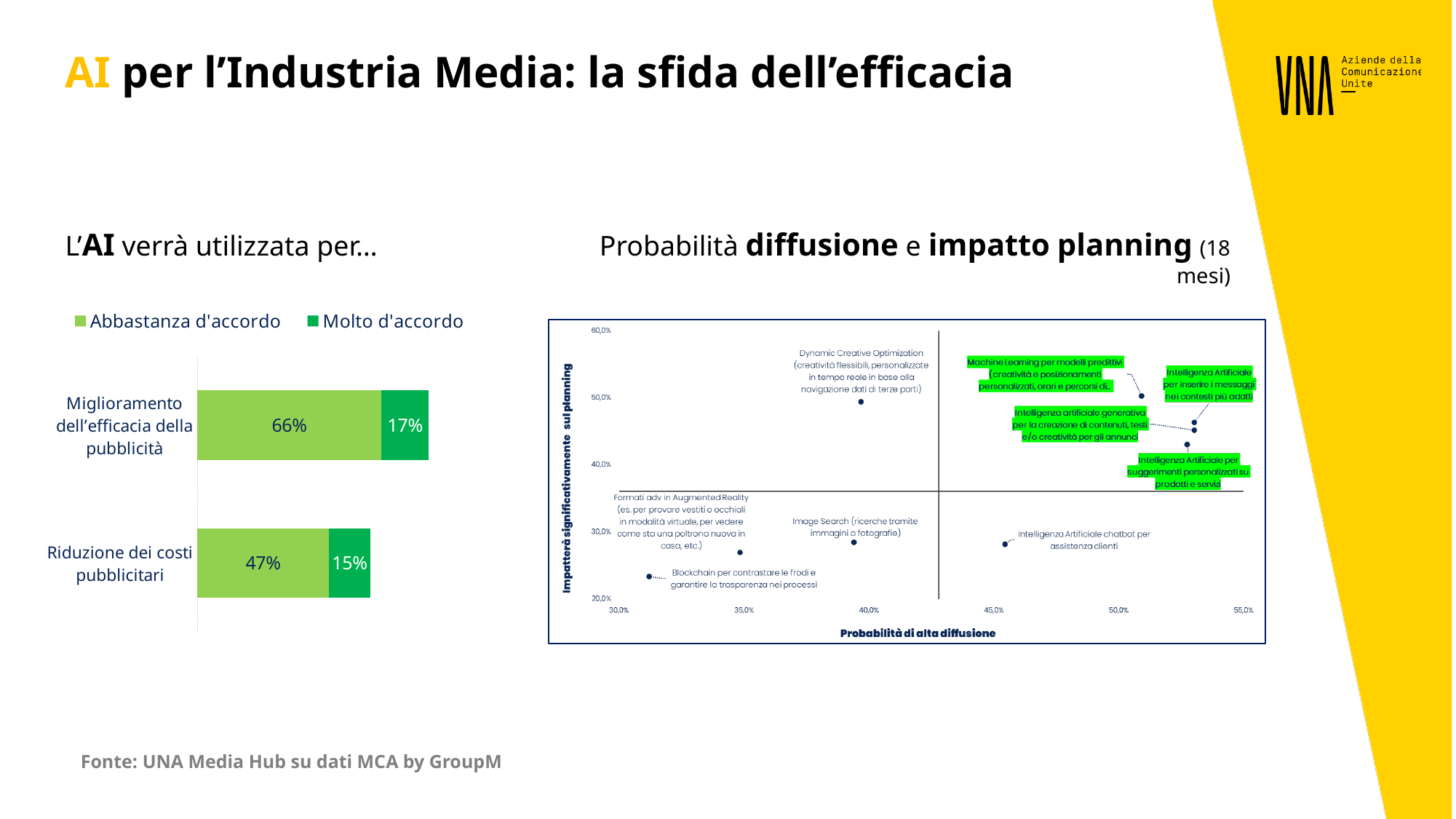
In the chart 'L'AI verrà utilizzata per...', what is the total of the stacked bar for 'Riduzione dei costi pubblicitari'? 62% In the chart 'L'AI verrà utilizzata per...', what is the total of the stacked bar for 'Miglioramento dell'efficacia della pubblicità'? 83% How many series does the legend of the chart 'L'AI verrà utilizzata per...' list? 2 How many data points are plotted in the chart 'Probabilità diffusione e impatto planning (18 mesi)'? 9 What is the label of the x axis in the chart 'Probabilità diffusione e impatto planning (18 mesi)'? Probabilità di alta diffusione What kind of chart is 'L'AI verrà utilizzata per...'? Stacked bar chart In the chart 'L'AI verrà utilizzata per...', what is the difference between the 'Abbastanza d'accordo' values of the two categories? 19 percentage points In the chart 'Probabilità diffusione e impatto planning (18 mesi)', is the 'Probabilità di alta diffusione' value for 'Blockchain per contrastare le frodi e garantire la trasparenza nei processi' greater or less than 35,0%? less What kind of chart is 'Probabilità diffusione e impatto planning (18 mesi)'? Scatter plot In the chart 'L'AI verrà utilizzata per...', what is the 'Abbastanza d'accordo' value for 'Miglioramento dell'efficacia della pubblicità'? 66% In the chart 'L'AI verrà utilizzata per...', what is the 'Molto d'accordo' value for 'Riduzione dei costi pubblicitari'? 15% In the chart 'L'AI verrà utilizzata per...', which category has the higher 'Molto d'accordo' value? Miglioramento dell'efficacia della pubblicità